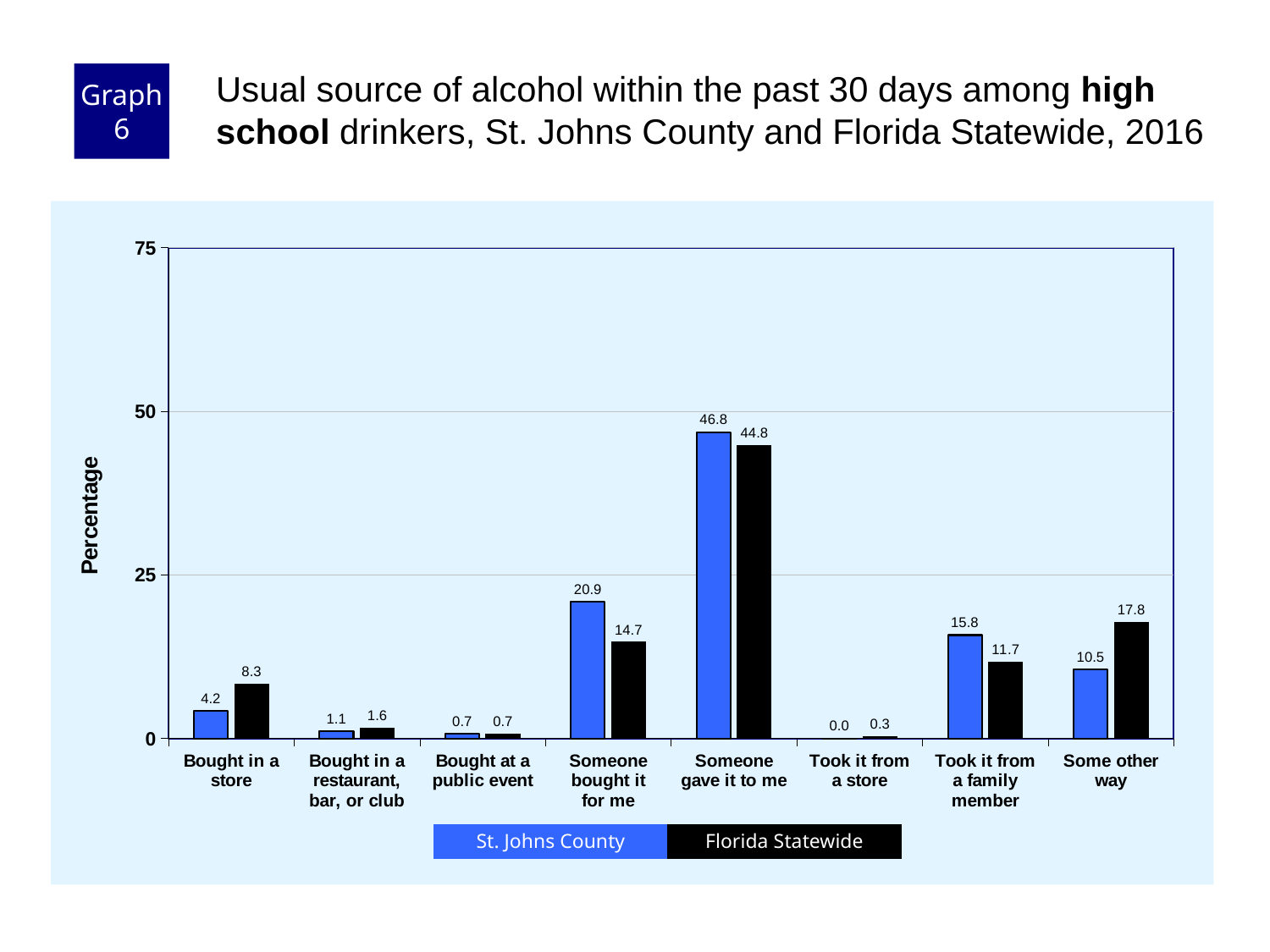
Is the Florida Statewide value for "Someone gave it to me" greater or less than 25? greater What is the difference between the St. Johns County and Florida Statewide values for "Someone bought it for me"? 6.2 How many series does the legend list? 2 What is the Florida Statewide value for "Took it from a store"? 0.3 Which is larger for "Bought in a store": St. Johns County or Florida Statewide? Florida Statewide What kind of chart is shown on the slide? Bar chart How many categories are shown on the x axis? 8 What is the label of the y axis? Percentage Which category has the highest St. Johns County value? Someone gave it to me What is the St. Johns County value for "Someone gave it to me"? 46.8 What is the Florida Statewide value for "Some other way"? 17.8 Which category has the lowest St. Johns County value? Took it from a store